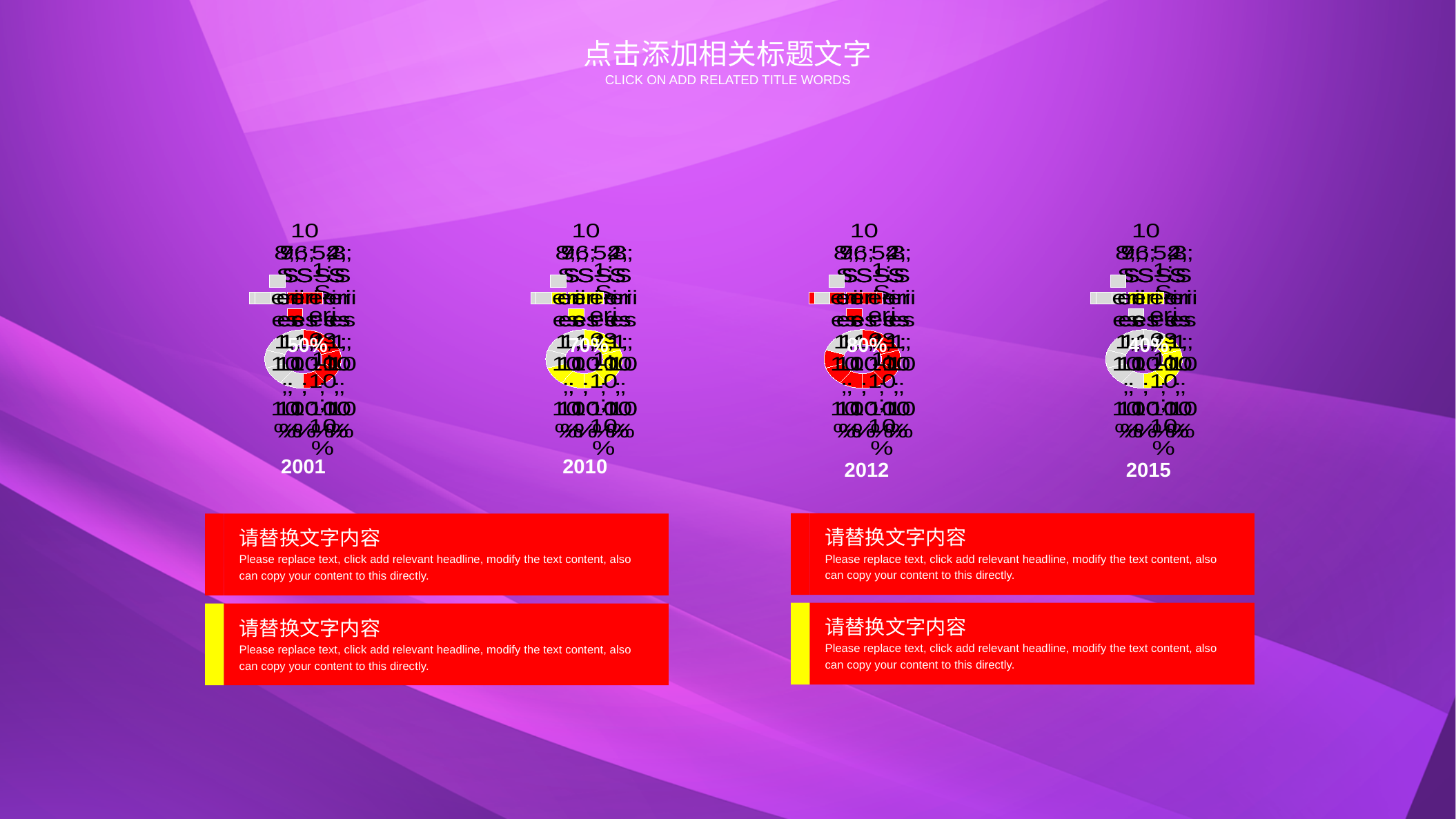
What percentage is shown in the centre of the chart labelled 2010? 70% What colour is the highlighted segment in the chart labelled 2010? yellow What percentage is shown in the centre of the chart labelled 2012? 80% Which year's chart shows the lowest centre percentage? 2015 How many doughnut charts are on the slide? 4 Which chart shows a larger centre percentage, the one labelled 2010 or the one labelled 2001? 2010 What colour is the highlighted segment in the chart labelled 2012? red What is the difference between the centre percentages of the 2012 chart and the 2001 chart? 30% What percentage is shown in the centre of the chart labelled 2015? 40% Which year's chart shows the highest centre percentage? 2012 What percentage is shown in the centre of the chart labelled 2001? 50% What kind of chart is shown above the label 2001? doughnut chart